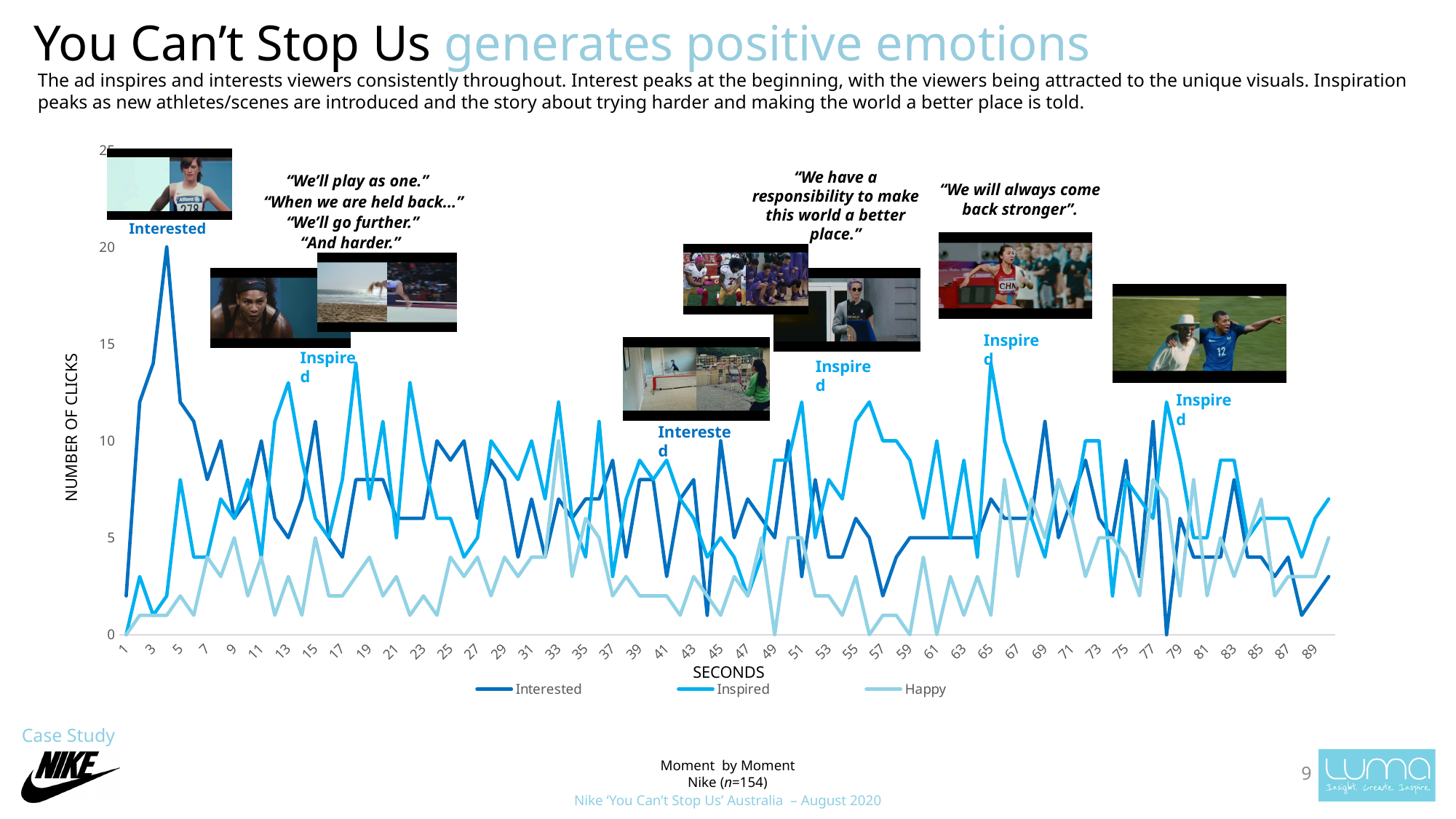
Is the value of the Inspired series at second 65 greater or less than 10? greater What are the three series named in the chart legend? Interested, Inspired, Happy What is the title of the vertical axis of the chart? NUMBER OF CLICKS Which series generally has the lowest values across the chart? Happy At second 4, which series has the larger value, Interested or Inspired? Interested Is the value of the Interested series at second 4 greater or less than 15? greater Which series reaches the highest value anywhere on the chart? Interested Does the Interested series rise or fall between second 1 and second 4? rise How many series does the chart legend list? 3 What is the highest tick value shown on the vertical axis? 25 What kind of chart is shown on the slide? line chart Is the value of the Happy series at second 1 greater or less than 5? less